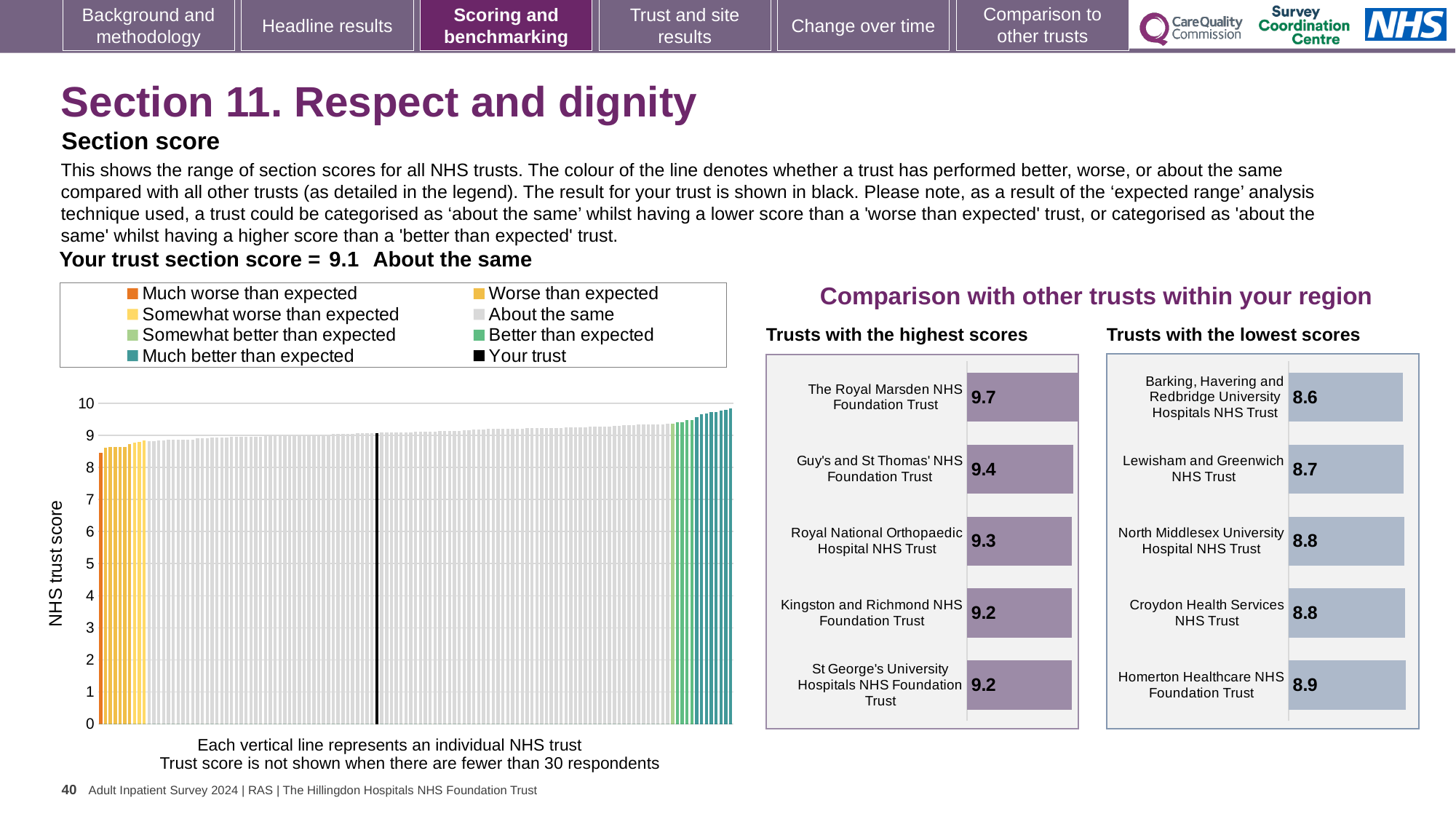
In the 'Trusts with the lowest scores' chart, which has the higher score: Homerton Healthcare NHS Foundation Trust or Croydon Health Services NHS Trust? Homerton Healthcare NHS Foundation Trust In the large chart on the left, what colour is used for the bar representing your trust? Black In the 'Trusts with the highest scores' chart, what is the difference between the scores of The Royal Marsden NHS Foundation Trust and Guy's and St Thomas' NHS Foundation Trust? 0.3 How many trusts are listed in the 'Trusts with the highest scores' chart? 5 What kind of chart is the large chart on the left showing NHS trust scores? Bar chart In the 'Trusts with the highest scores' chart, what is the score for The Royal Marsden NHS Foundation Trust? 9.7 In the 'Trusts with the highest scores' chart, which trust has the highest score? The Royal Marsden NHS Foundation Trust In the 'Trusts with the lowest scores' chart, what is the score for Lewisham and Greenwich NHS Trust? 8.7 In the 'Trusts with the lowest scores' chart, what is the difference between the scores of Homerton Healthcare NHS Foundation Trust and Barking, Havering and Redbridge University Hospitals NHS Trust? 0.3 In the large chart on the left, is the value of the leftmost bar greater or less than 9? less In the 'Trusts with the lowest scores' chart, which trust has the lowest score? Barking, Havering and Redbridge University Hospitals NHS Trust In the 'Trusts with the highest scores' chart, what is the score for Kingston and Richmond NHS Foundation Trust? 9.2